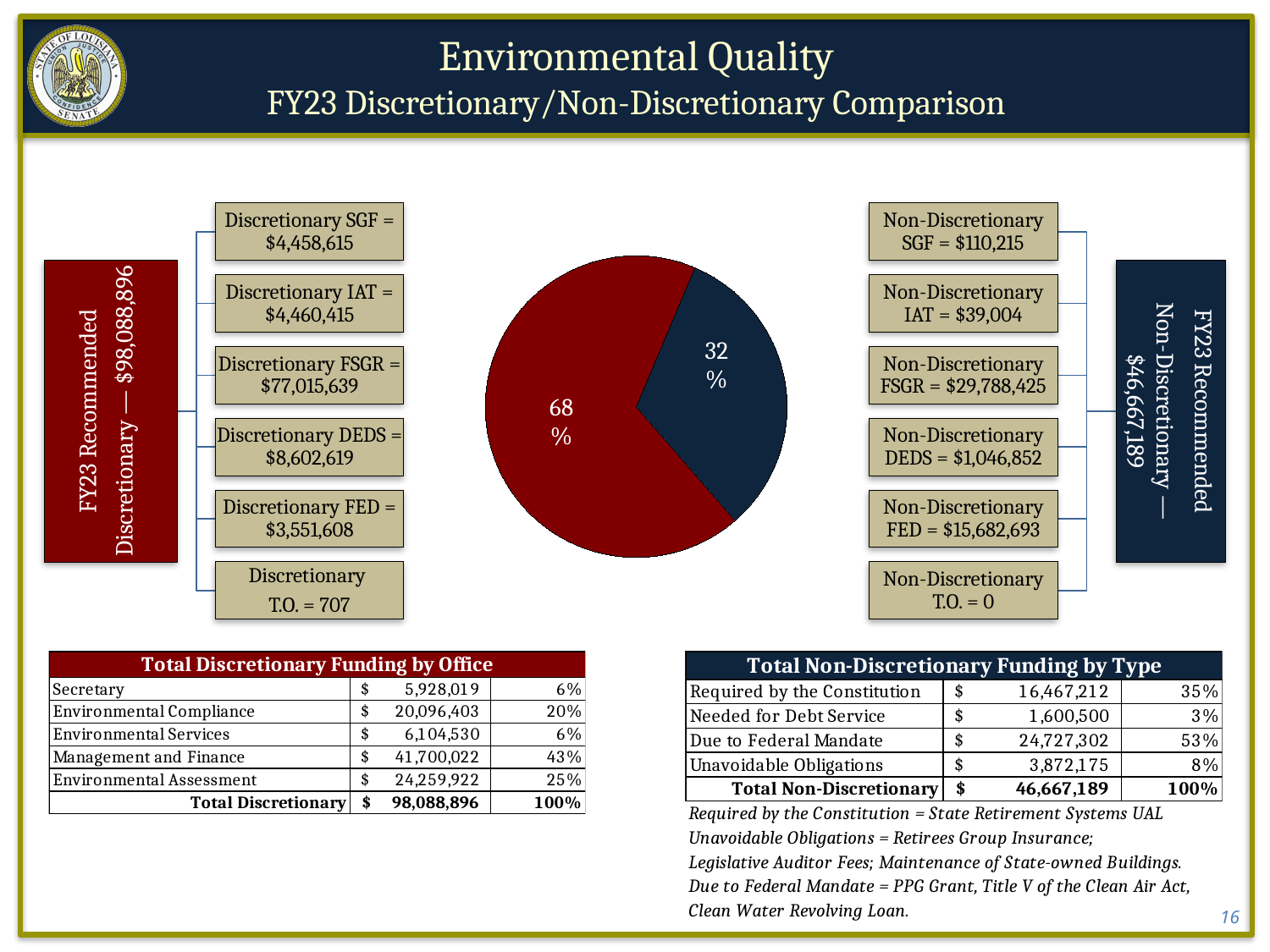
Which slice of the pie chart is larger, the red slice or the dark blue slice? the red slice What colour is the slice of the pie chart labelled 68%? red What is the difference in percentage points between the two slices of the pie chart? 36 Which slice of the pie chart has the smallest share? the dark blue slice (32%) Is the share of the dark blue slice in the pie chart greater or less than 50%? less What share of the pie does the red slice represent? 68% What percentage is shown on the larger (red) slice of the pie chart? 68% What colour is the slice of the pie chart labelled 32%? dark blue How many slices does the pie chart have? 2 What percentage is shown on the smaller (dark blue) slice of the pie chart? 32% What kind of chart is shown in the center of the slide? pie chart